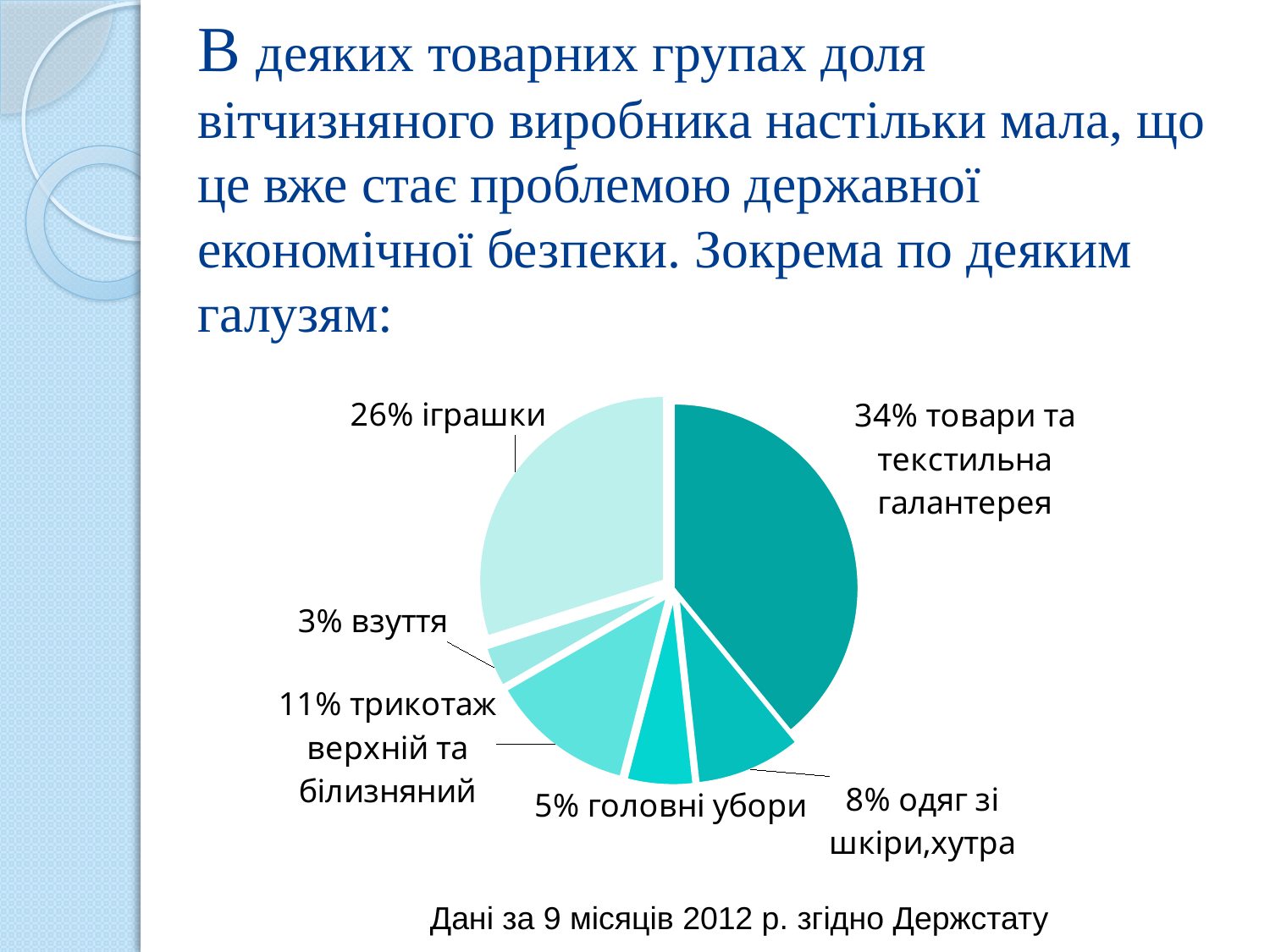
What type of chart is shown on the slide? pie chart Which category has the smallest slice of the pie? взуття How many slices does the pie chart have? 6 What percentage is shown for одяг зі шкіри,хутра? 8% Which is larger, the slice for трикотаж верхній та білизняний or the slice for одяг зі шкіри,хутра? трикотаж верхній та білизняний What percentage is shown for головні убори? 5% What is the difference in percentage points between іграшки and головні убори? 21 What percentage is shown for товари та текстильна галантерея? 34% What percentage is shown for взуття? 3% What percentage is shown for трикотаж верхній та білизняний? 11% Which category has the largest slice of the pie? товари та текстильна галантерея What percentage is shown for іграшки? 26%